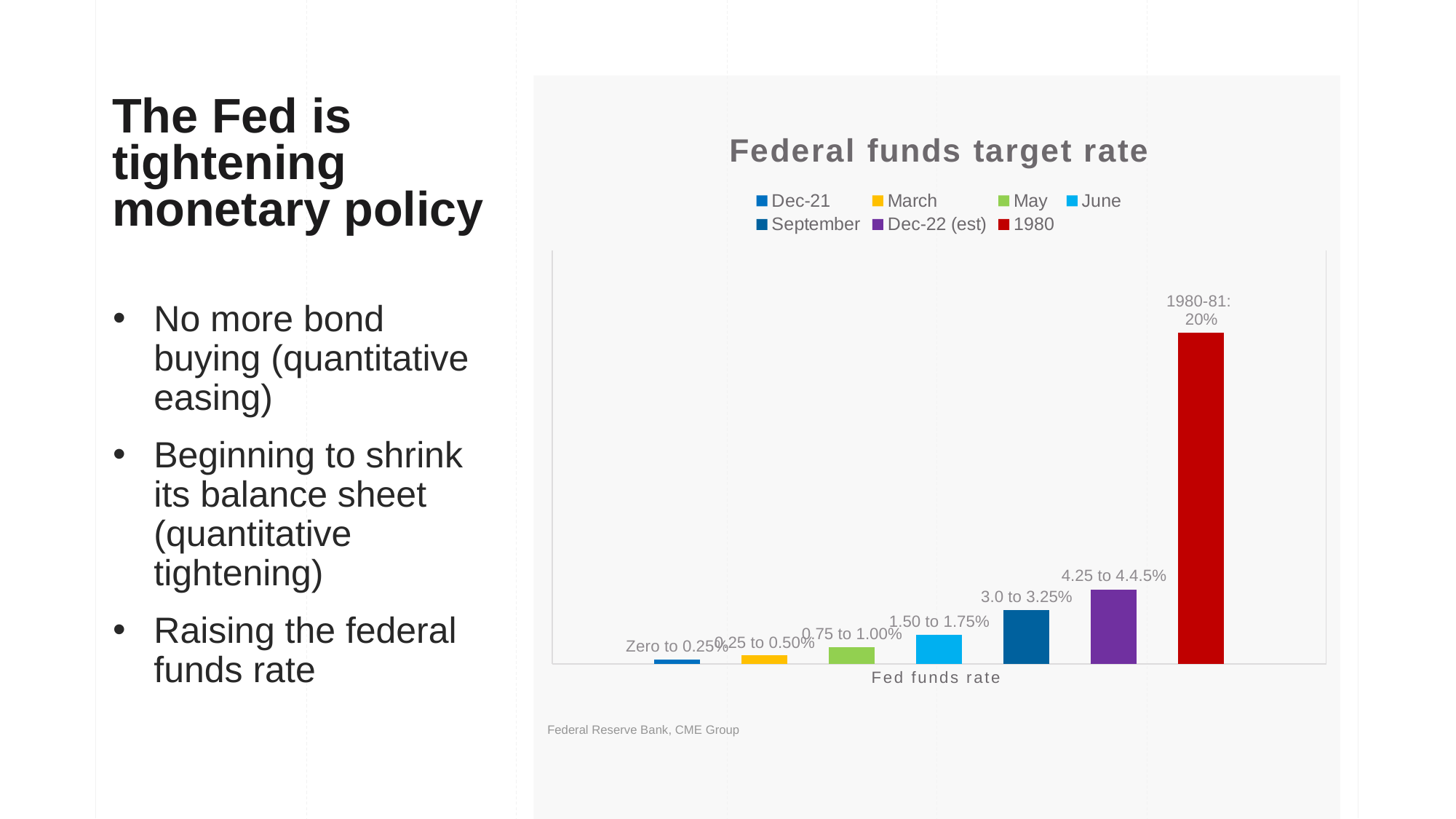
What is the title of the chart? Federal funds target rate Which series has the tallest bar? 1980 Which bar is taller, September or Dec-22 (est)? Dec-22 (est) How many series does the legend list? 7 What is the data label on the June bar? 1.50 to 1.75% What is the data label on the September bar? 3.0 to 3.25% Do the bars from Dec-21 through Dec-22 (est) rise or fall from left to right? Rise What type of chart is shown on the slide? Bar chart Which series has the shortest bar? Dec-21 What is the data label on the Dec-21 bar? Zero to 0.25% What is the data label on the March bar? 0.25 to 0.50% What is the data label on the 1980 bar? 1980-81: 20%